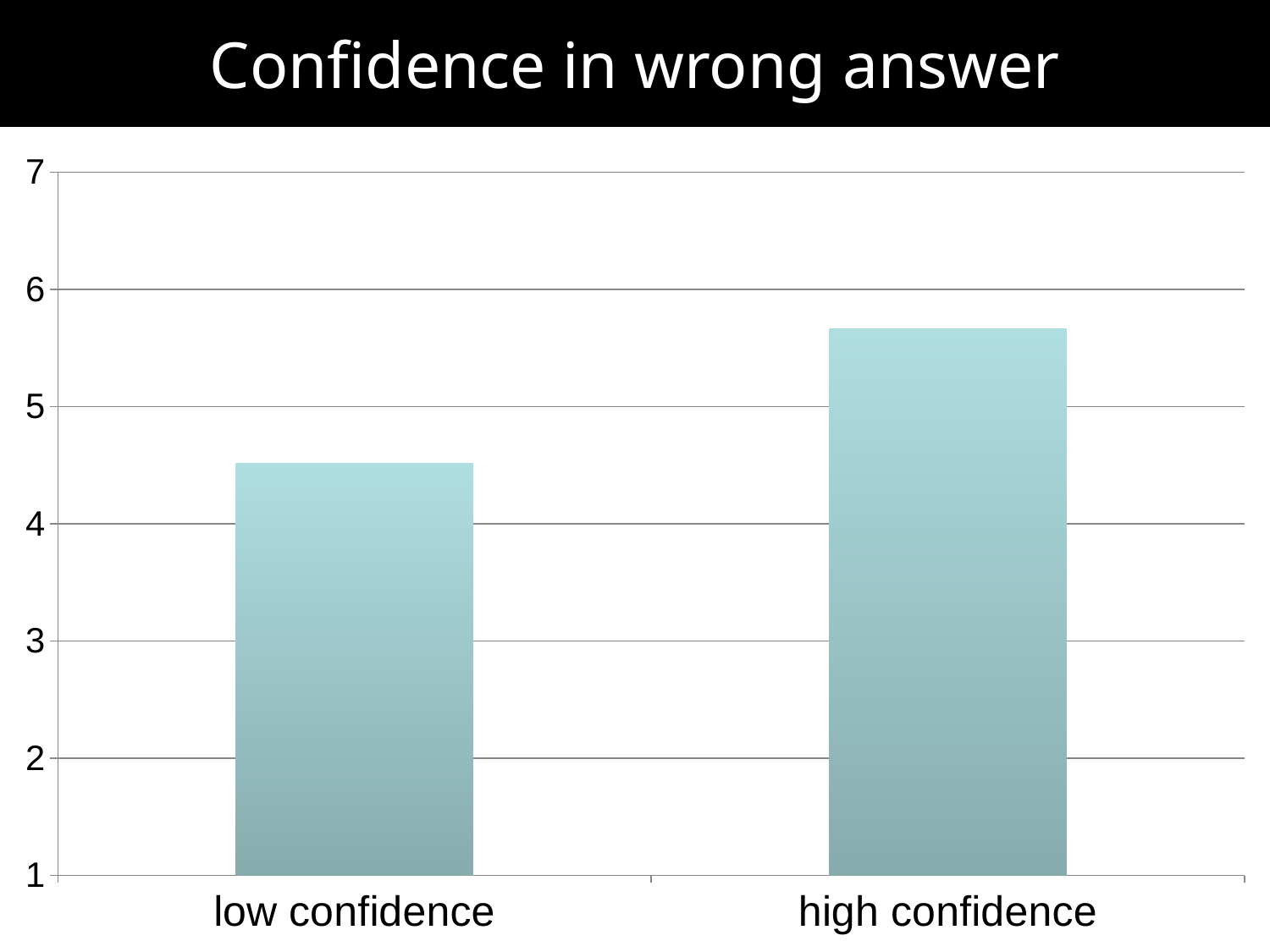
Is the value for low confidence greater or less than 5? less Which category has the highest value? high confidence Which is larger, the value for low confidence or the value for high confidence? high confidence Is the value for high confidence greater or less than 5? greater What type of chart is shown on the slide? bar chart Which category has the lowest value? low confidence Do the values rise or fall from low confidence to high confidence? rise Is the value for high confidence greater or less than 6? less What is the title of the chart? Confidence in wrong answer How many categories are shown on the x axis? 2 What is the lowest value shown on the y axis? 1